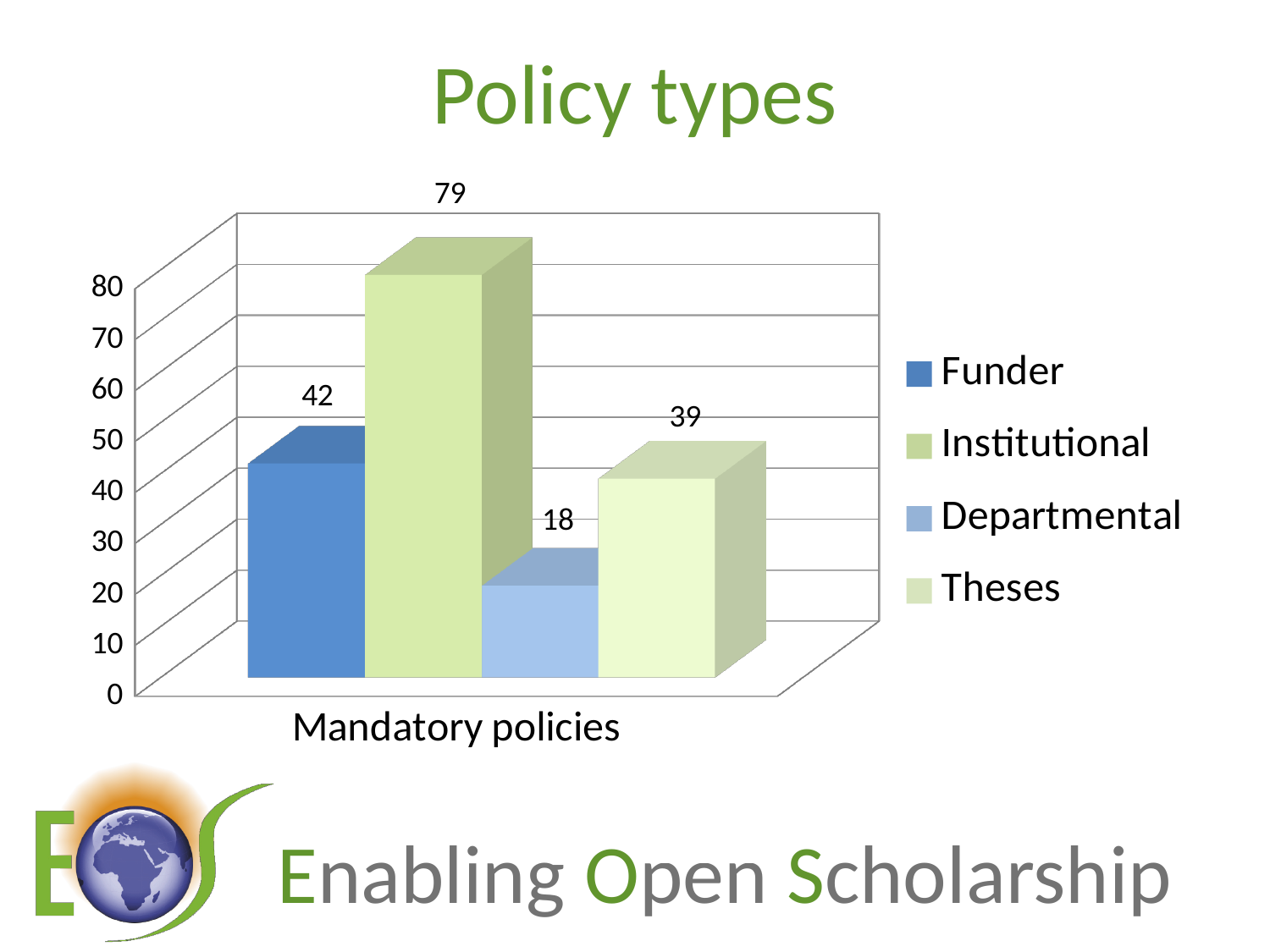
What is the value for Institutional in the Policy types chart? 79 What is the difference between the Institutional and Funder values? 37 What kind of chart is shown on the slide? Bar chart What is the value for Theses in the Policy types chart? 39 Which series has the lowest value in the Policy types chart? Departmental What is the category label shown on the x axis of the chart? Mandatory policies What is the value for Departmental in the Policy types chart? 18 Which is larger, the value for Funder or the value for Theses? Funder How many series does the legend list? 4 What is the difference between the Theses and Departmental values? 21 What is the value for Funder in the Policy types chart? 42 Which series has the highest value in the Policy types chart? Institutional